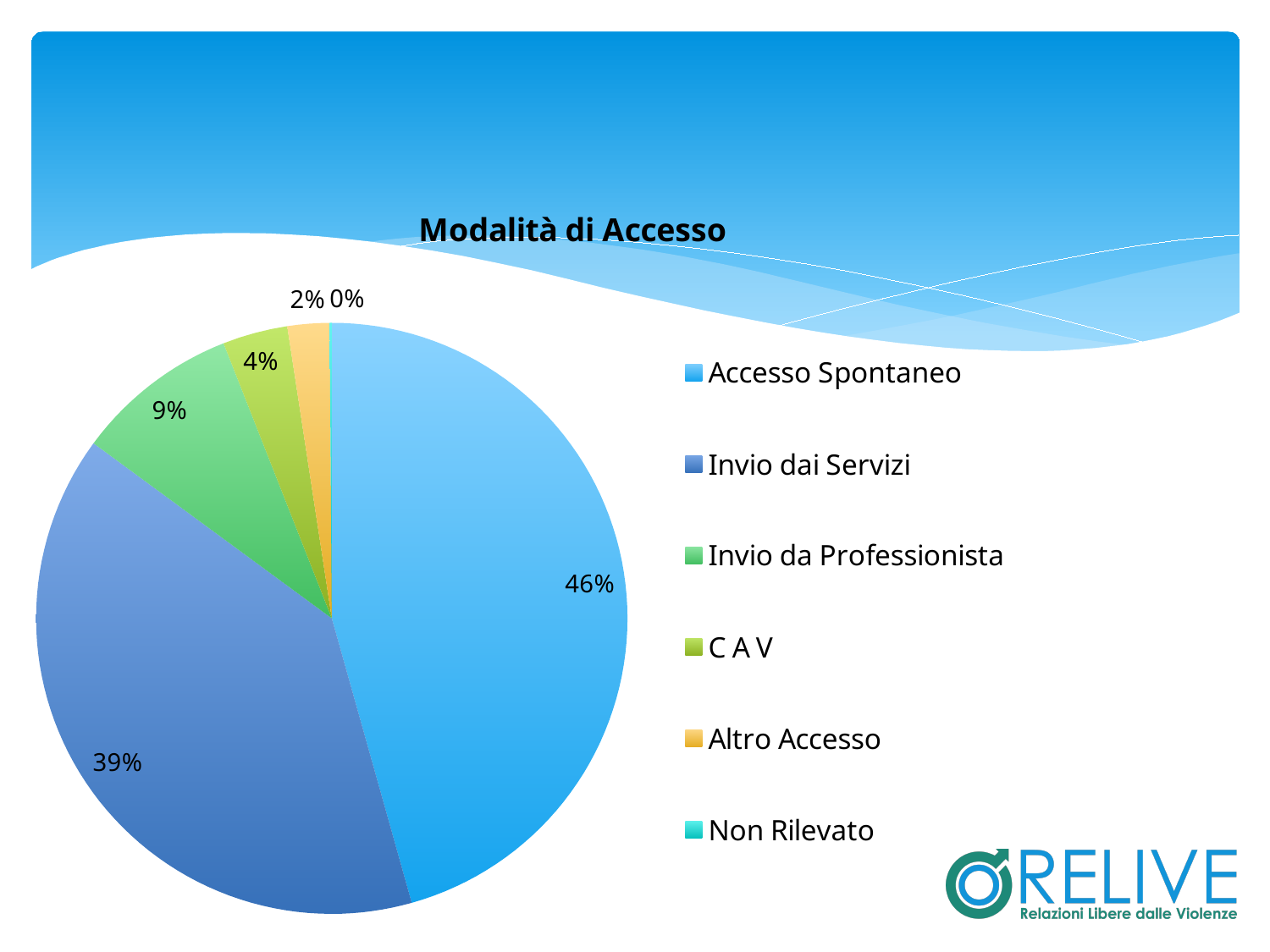
Which category has the largest slice of the pie? Accesso Spontaneo What share of the pie does Altro Accesso represent? 2% What share of the pie does Accesso Spontaneo represent? 46% What type of chart is shown on the slide? pie chart What share of the pie does Non Rilevato represent? 0% What is the difference in percentage points between Accesso Spontaneo and Invio dai Servizi? 7% What is the title of the chart? Modalità di Accesso Which category has the smallest slice of the pie? Non Rilevato How many categories does the legend list? 6